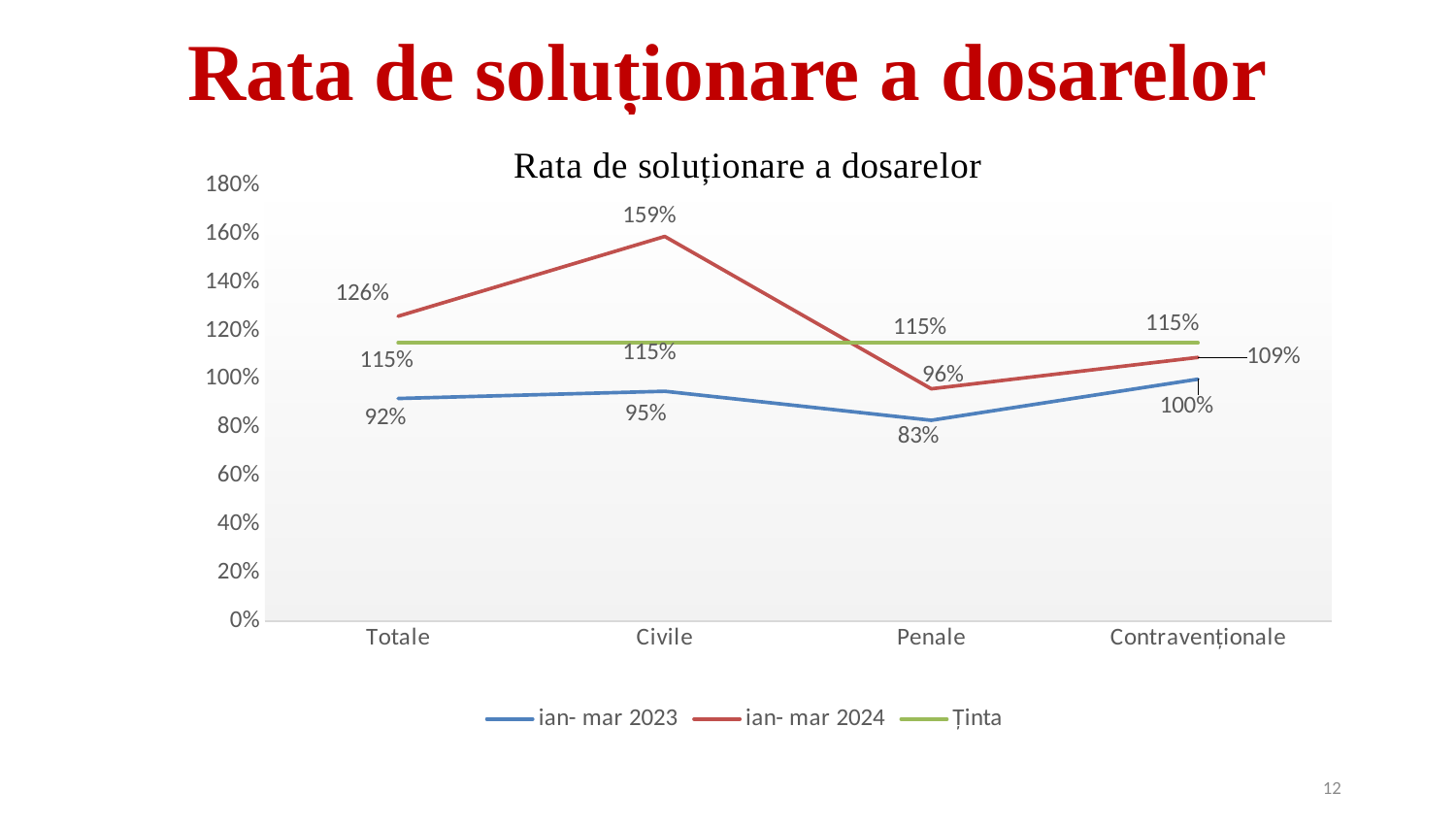
What is the value for Penale in the ian- mar 2023 series? 83% Which category has the highest value in the ian- mar 2024 series? Civile What is the Ținta value for Totale? 115% What is the title of the chart? Rata de soluționare a dosarelor Which category has the lowest value in the ian- mar 2023 series? Penale What is the value for Contravenționale in the ian- mar 2024 series? 109% What kind of chart is shown on the slide? line chart How many categories are shown on the x axis? 4 What is the value for Civile in the ian- mar 2024 series? 159% Which is larger for Penale: the ian- mar 2024 value or the Ținta value? Ținta What is the difference between the ian- mar 2024 and ian- mar 2023 values for Civile? 64% How many series does the legend list? 3